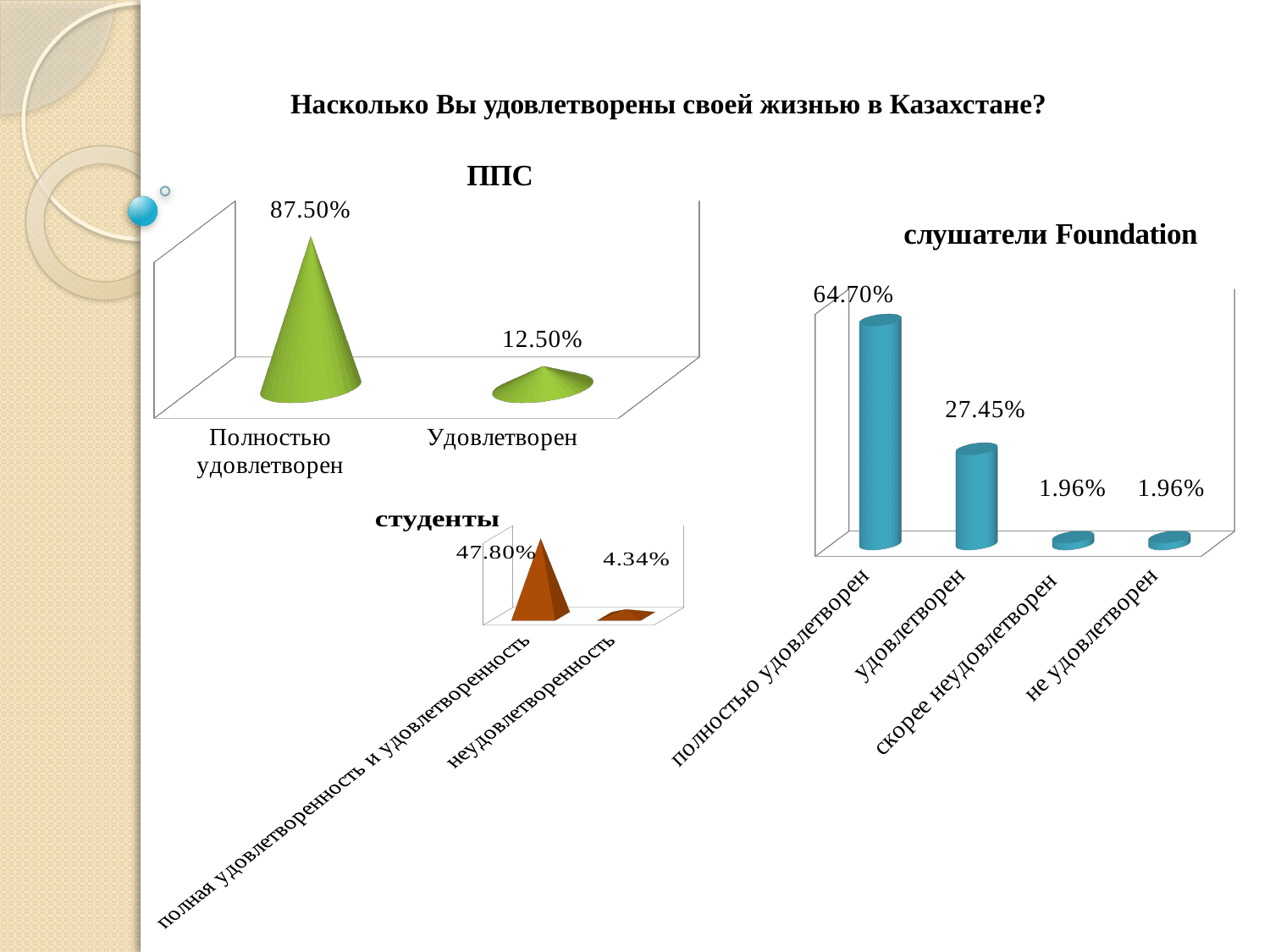
What kind of chart is the слушатели Foundation chart? Bar chart In the слушатели Foundation chart, what is the difference between полностью удовлетворен and удовлетворен? 37.25% In the студенты chart, what is the value for неудовлетворенность? 4.34% In the слушатели Foundation chart, what is the value for удовлетворен? 27.45% In the ППС chart, what is the value for Полностью удовлетворен? 87.50% In the ППС chart, what is the difference between Полностью удовлетворен and Удовлетворен? 75.00% In the студенты chart, what is the value for полная удовлетворенность и удовлетворенность? 47.80% In the ППС chart, how many categories are shown? 2 In the слушатели Foundation chart, what is the value for скорее неудовлетворен? 1.96% In the слушатели Foundation chart, how many categories are shown? 4 In the слушатели Foundation chart, which category has the highest value? полностью удовлетворен In the ППС chart, what is the value for Удовлетворен? 12.50%